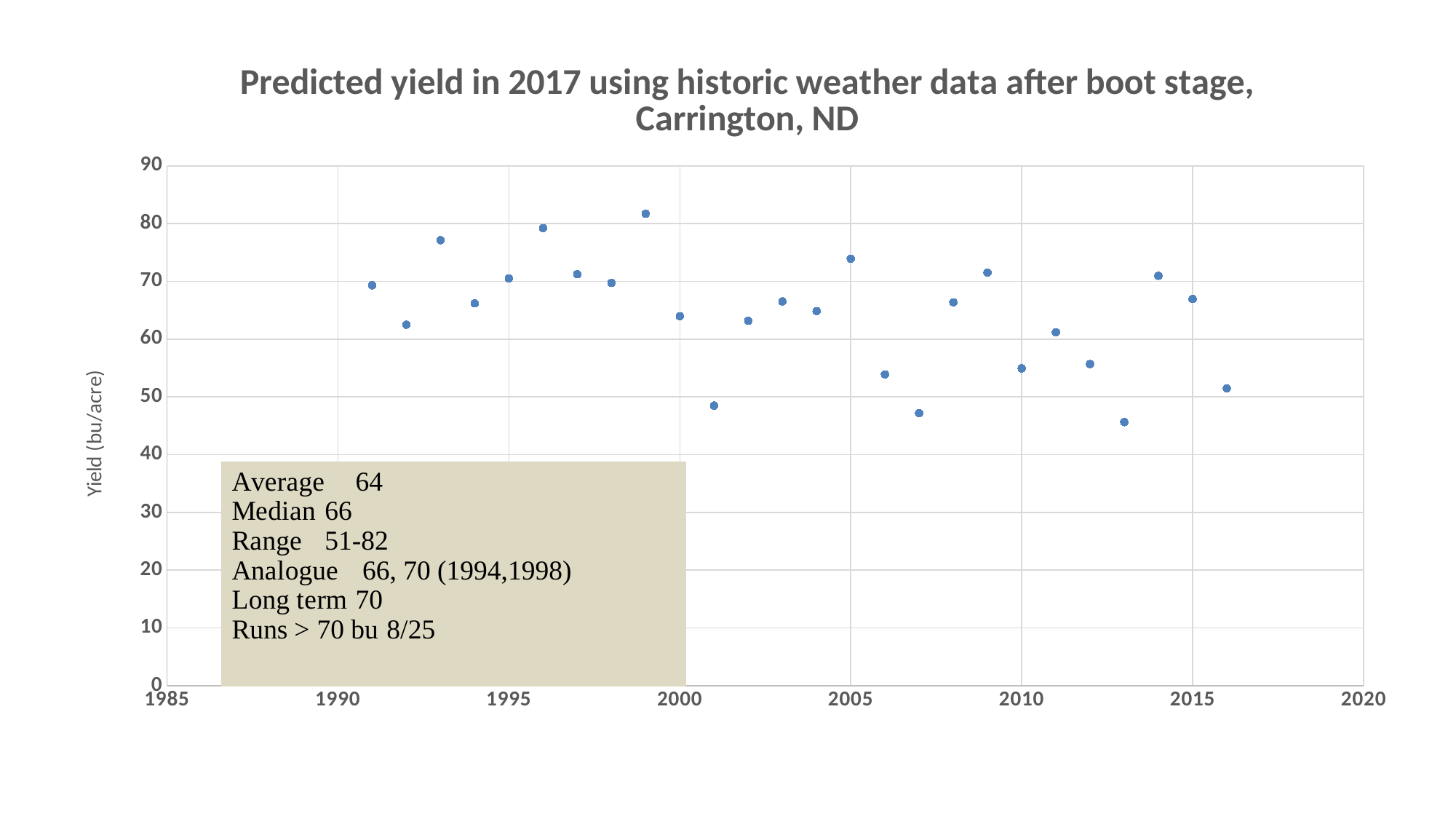
Which year has the higher predicted yield, 2005 or 2007? 2005 Is the predicted yield for 2013 greater or less than 50? less What kind of chart is shown on the slide? scatter chart Is the predicted yield for 2006 greater or less than 60? less What is the title of the chart? Predicted yield in 2017 using historic weather data after boot stage, Carrington, ND Is the predicted yield for 2005 greater or less than 70? greater Which year has the higher predicted yield, 1992 or 1993? 1993 What is the label of the vertical axis? Yield (bu/acre) How many data points are plotted on the chart? 26 Which year has the lowest predicted yield? 2013 Which year has the highest predicted yield? 1999